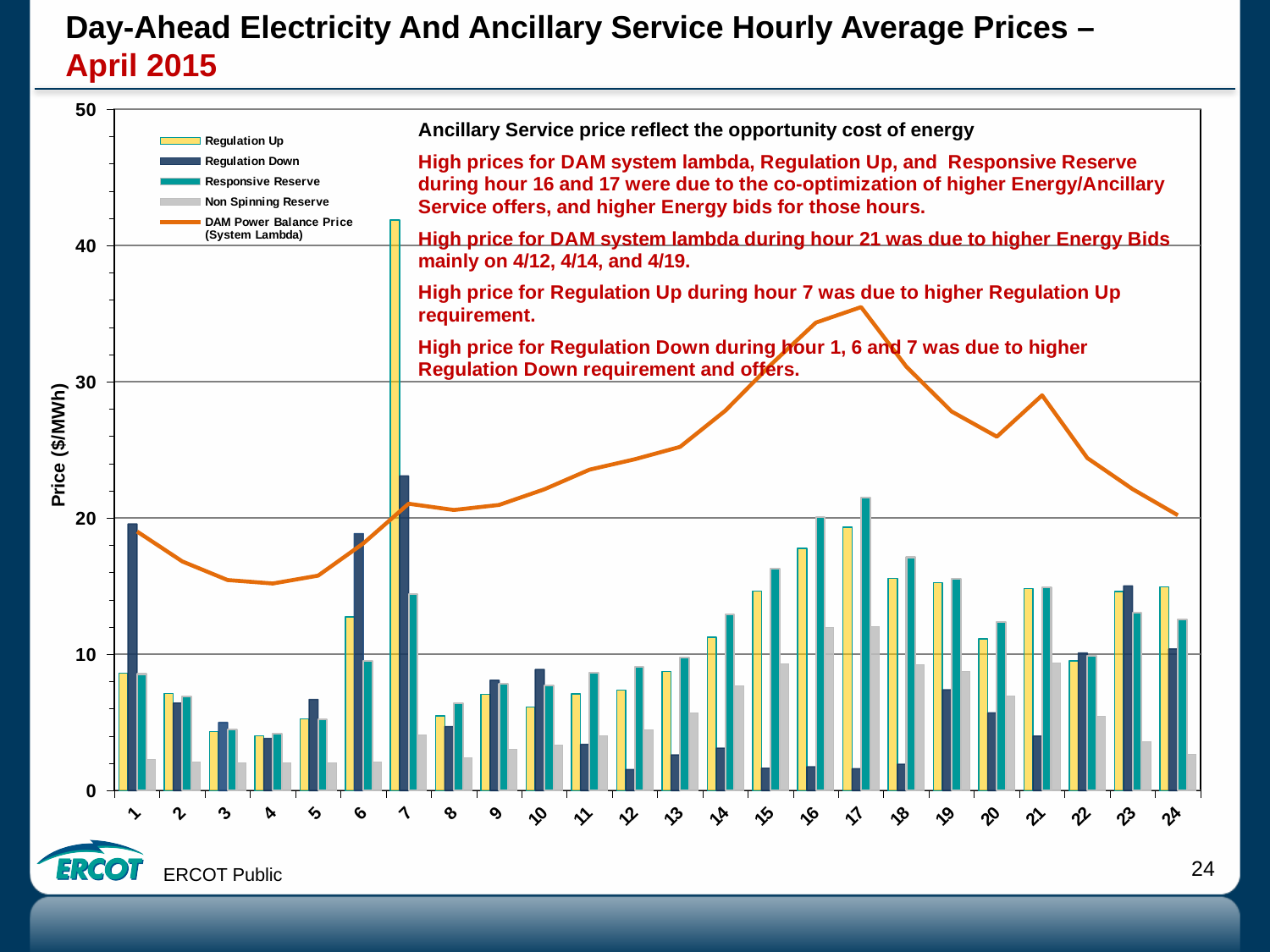
Is the Responsive Reserve value at hour 17 greater or less than 20? greater At hour 16, which is larger: Regulation Up or Responsive Reserve? Responsive Reserve How many hours are shown along the x axis? 24 Does the DAM Power Balance Price line rise or fall from hour 8 to hour 17? Rise What is the label on the y axis? Price ($/MWh) At which hour does the DAM Power Balance Price (System Lambda) line reach its peak? 17 Is the Regulation Up value at hour 7 greater or less than 40? greater Is the DAM Power Balance Price at hour 4 greater or less than 20? less At which hour is the Regulation Up price highest? 7 What kind of chart is shown on the slide? Bar chart with a line How many series does the legend list? 5 At which hour is the Regulation Down price highest? 7